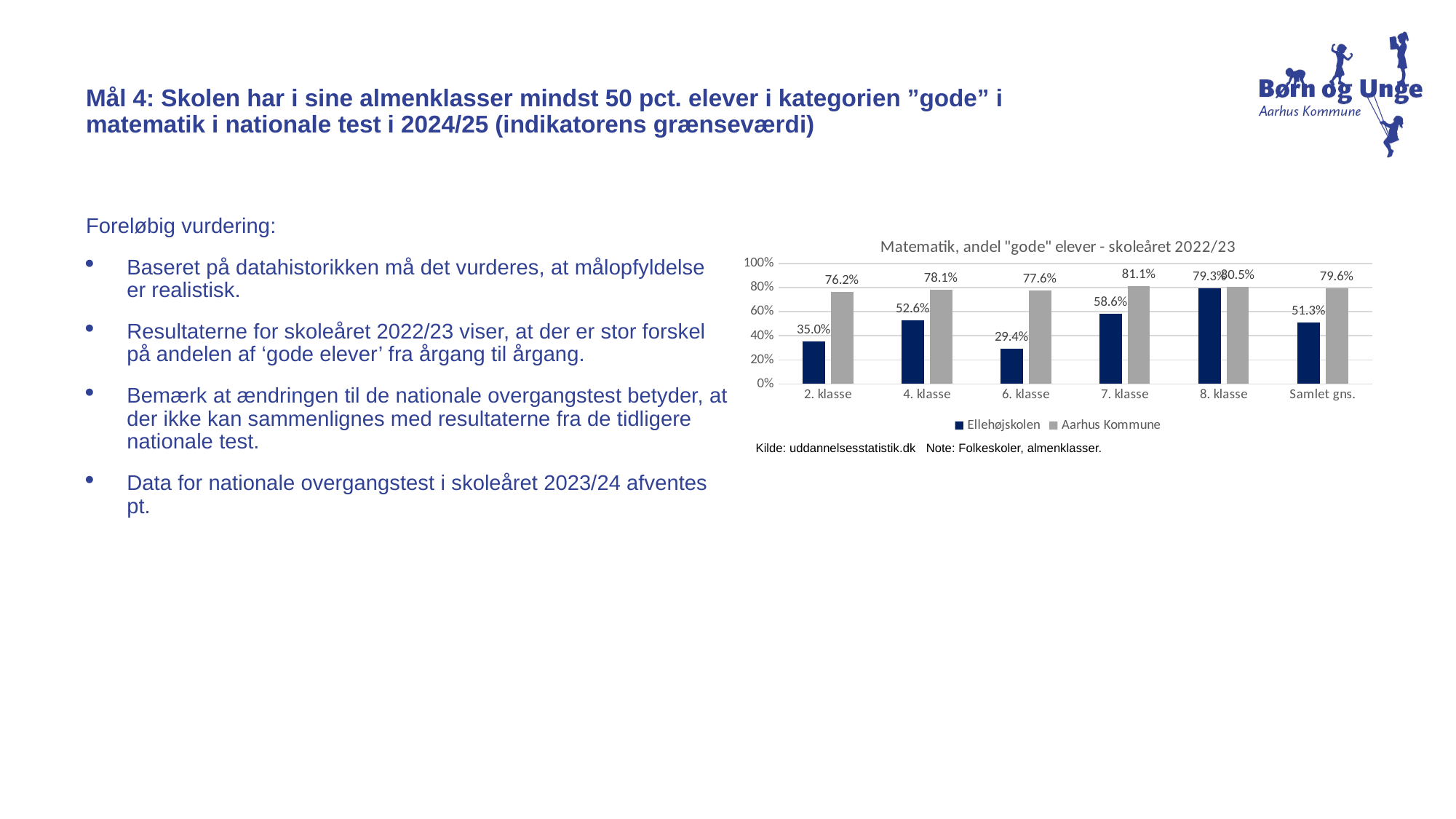
What is the difference between the Aarhus Kommune and Ellehøjskolen values in 2. klasse? 41.2 percentage points Is the value for Ellehøjskolen in 7. klasse greater or less than 40%? greater Which category has the lowest value for Ellehøjskolen? 6. klasse What is the value for Aarhus Kommune in 4. klasse? 78.1% What is the value for Ellehøjskolen for Samlet gns.? 51.3% What is the value for Aarhus Kommune in 6. klasse? 77.6% How many series does the legend list? 2 What is the value for Ellehøjskolen in 2. klasse? 35.0% Which category has the highest value for Ellehøjskolen? 8. klasse What kind of chart is shown on the slide? bar chart In 4. klasse, which series has the larger value, Ellehøjskolen or Aarhus Kommune? Aarhus Kommune How many categories are shown on the x axis? 6